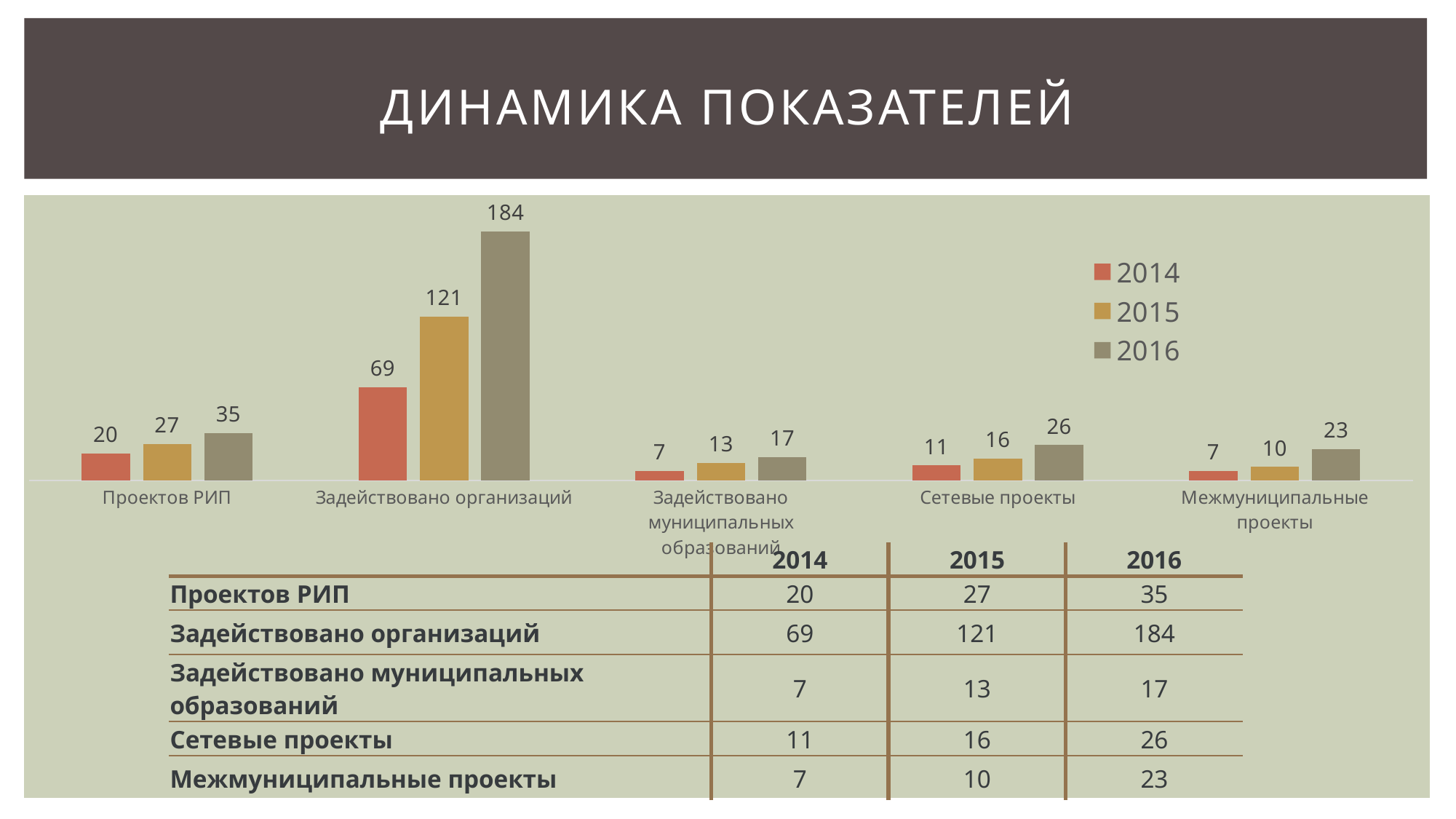
Do the values for Проектов РИП rise or fall from 2014 to 2016? Rise What is the value for Задействовано организаций in 2016? 184 What kind of chart is shown on the slide? Bar chart Which category has the highest value in 2016? Задействовано организаций What is the difference between the 2016 and 2014 values for Задействовано организаций? 115 Which is larger: Сетевые проекты in 2016 or Межмуниципальные проекты in 2016? Сетевые проекты How many series does the legend list? 3 What is the value for Сетевые проекты in 2015? 16 How many categories are shown on the x axis? 5 Which category has the lowest value in 2015? Межмуниципальные проекты Which colour represents the 2014 series in the legend? Red What is the value for Проектов РИП in 2014? 20